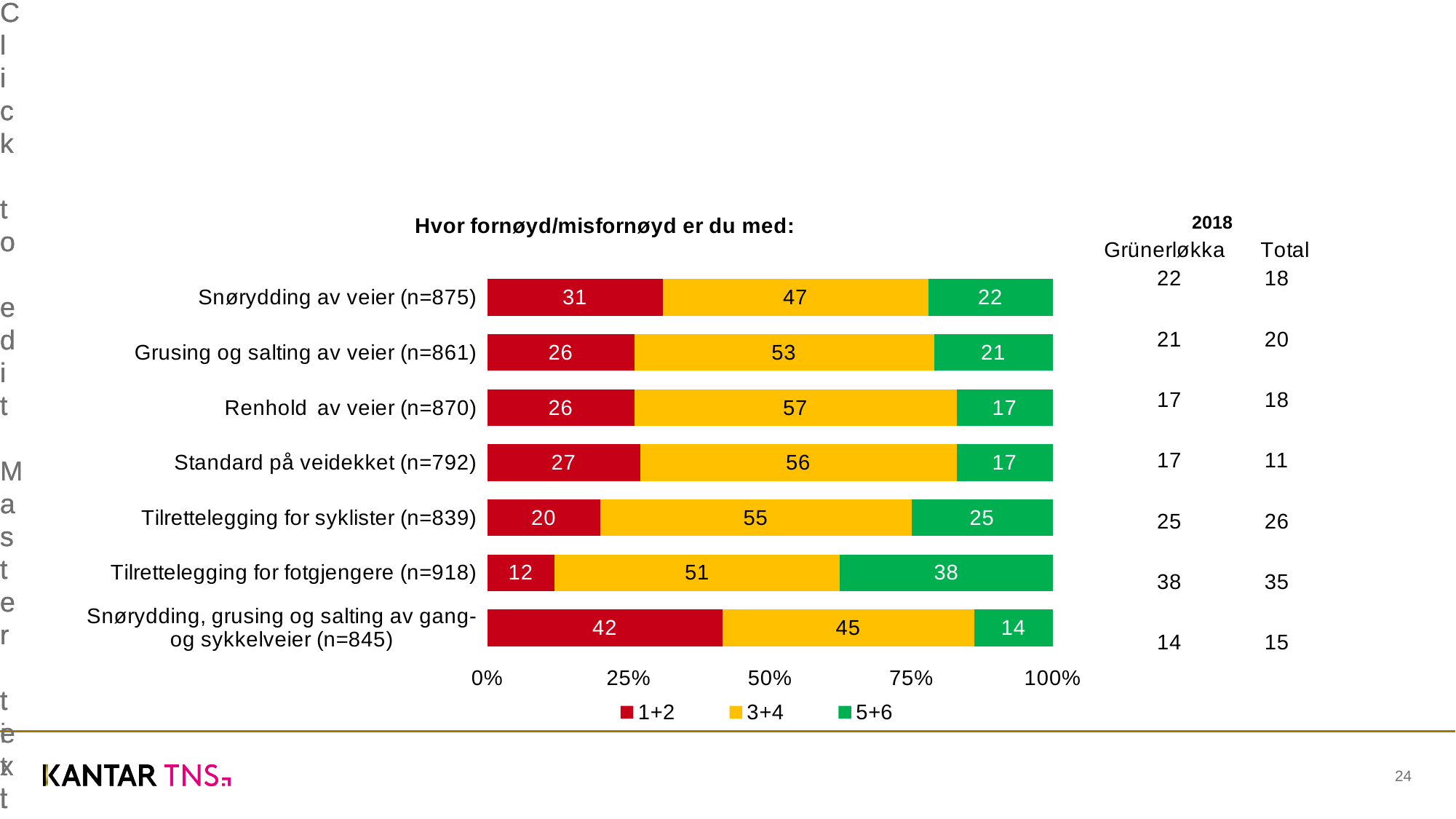
Which category has the lowest value for the 5+6 series? Snørydding, grusing og salting av gang- og sykkelveier (n=845) What is the value of the 3+4 series for Renhold av veier (n=870)? 57 What is the title of the chart? Hvor fornøyd/misfornøyd er du med: Which is larger: the 3+4 value for Grusing og salting av veier (n=861) or the 3+4 value for Snørydding av veier (n=875)? Grusing og salting av veier (n=861) Which category has the lowest value for the 1+2 series? Tilrettelegging for fotgjengere (n=918) How many series does the legend list? 3 What is the difference between the 5+6 values for Tilrettelegging for fotgjengere (n=918) and Tilrettelegging for syklister (n=839)? 13 What type of chart is shown on the slide? Stacked bar chart Which category has the highest value for the 1+2 series? Snørydding, grusing og salting av gang- og sykkelveier (n=845) How many categories are plotted in the chart? 7 What is the value of the 1+2 series for Snørydding av veier (n=875)? 31 What is the value of the 5+6 series for Tilrettelegging for fotgjengere (n=918)? 38